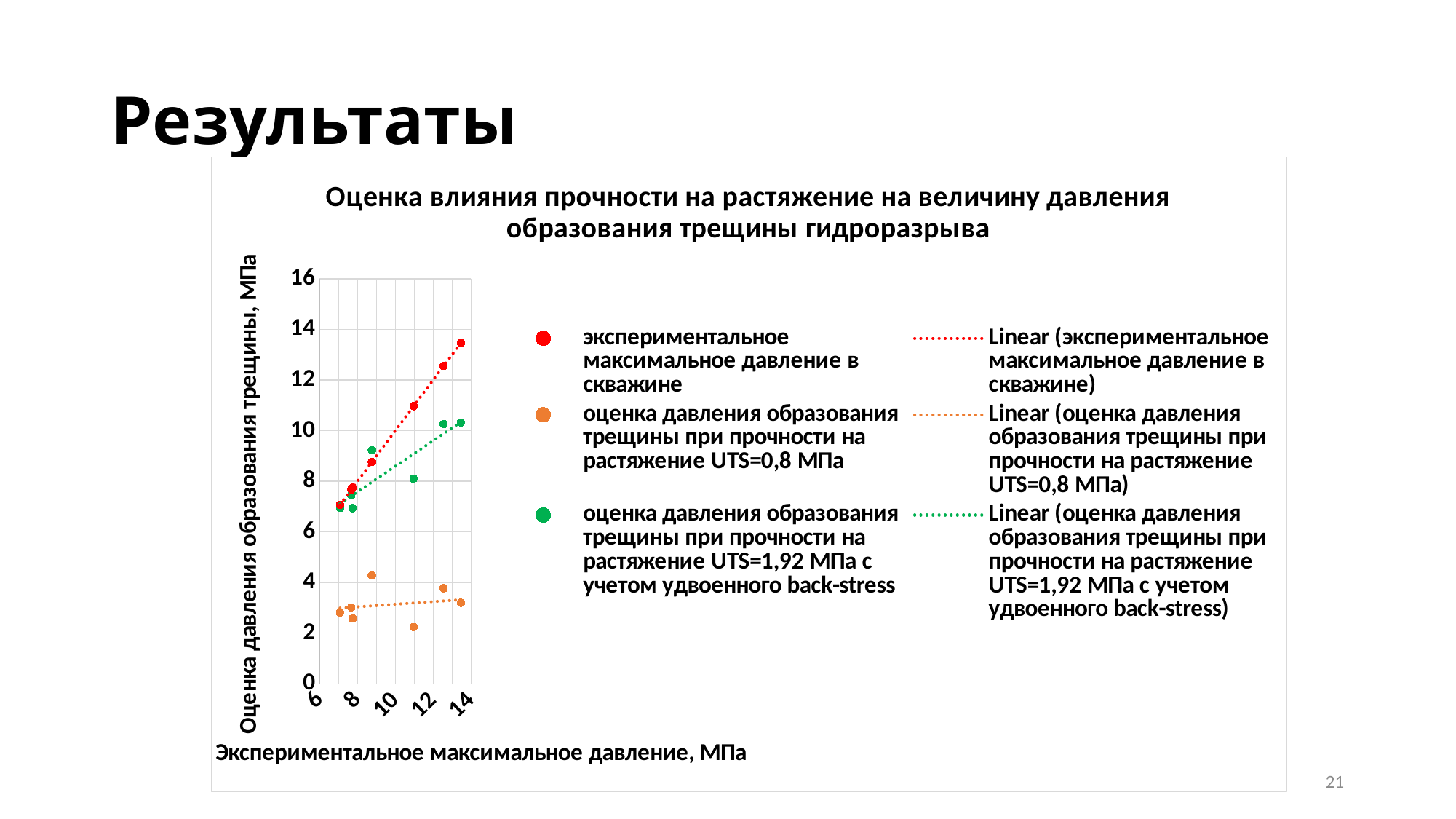
At the rightmost x value (around 14), which series has the larger value: the red series or the orange series? the red series Do the values of the green series rise or fall as the x value increases? rise At the rightmost x value (around 14), which series has the larger value: the red series or the green series? the red series Do the values of the red series rise or fall as the x value increases? rise Is the highest point of the red series (экспериментальное максимальное давление в скважине) greater or less than 12? greater What is the label of the x axis? Экспериментальное максимальное давление, МПа What is the title of the chart? Оценка влияния прочности на растяжение на величину давления образования трещины гидроразрыва Is the highest point of the green series (UTS=1,92 МПа с учетом удвоенного back-stress) greater or less than 12? less Are the values of the orange series (оценка давления образования трещины при прочности на растяжение UTS=0,8 МПа) greater or less than 6? less How many entries does the chart legend list? 6 What kind of chart is shown on the slide? scatter chart